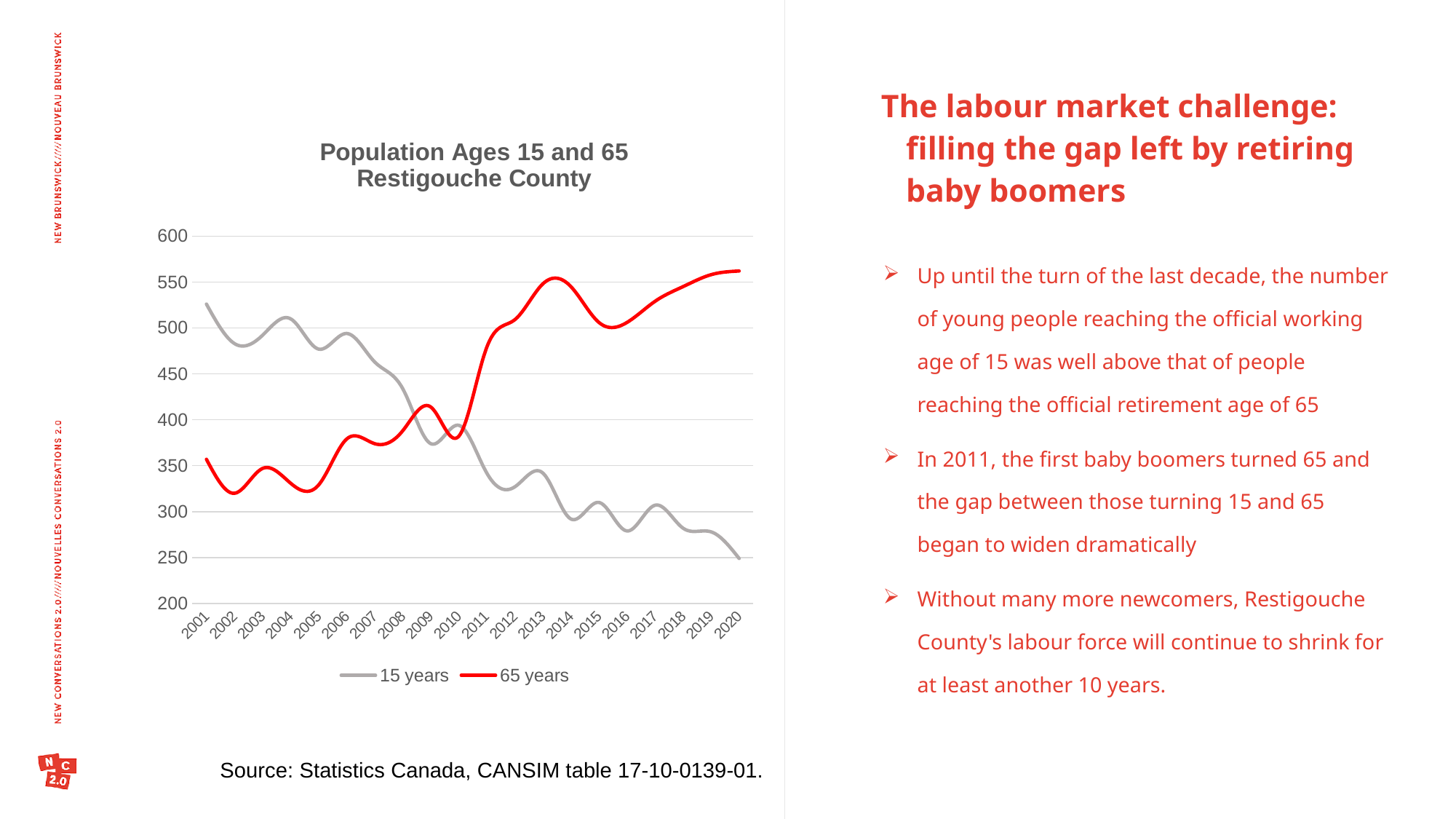
How many series does the legend list? 2 Is the value for 15 years in 2001 greater or less than 500? greater In 2020, which series has the larger value, 15 years or 65 years? 65 years What kind of chart is shown on the slide? Line chart Does the 65 years series rise or fall from 2001 to 2020? Rise Which colour is used for the 65 years series? Red How many years are plotted along the x axis? 20 In 2001, which series has the larger value, 15 years or 65 years? 15 years Is the value for 65 years in 2002 greater or less than 350? less Does the 15 years series rise or fall from 2001 to 2020? Fall Is the value for 15 years in 2020 greater or less than 300? less What is the title of the chart? Population Ages 15 and 65 Restigouche County